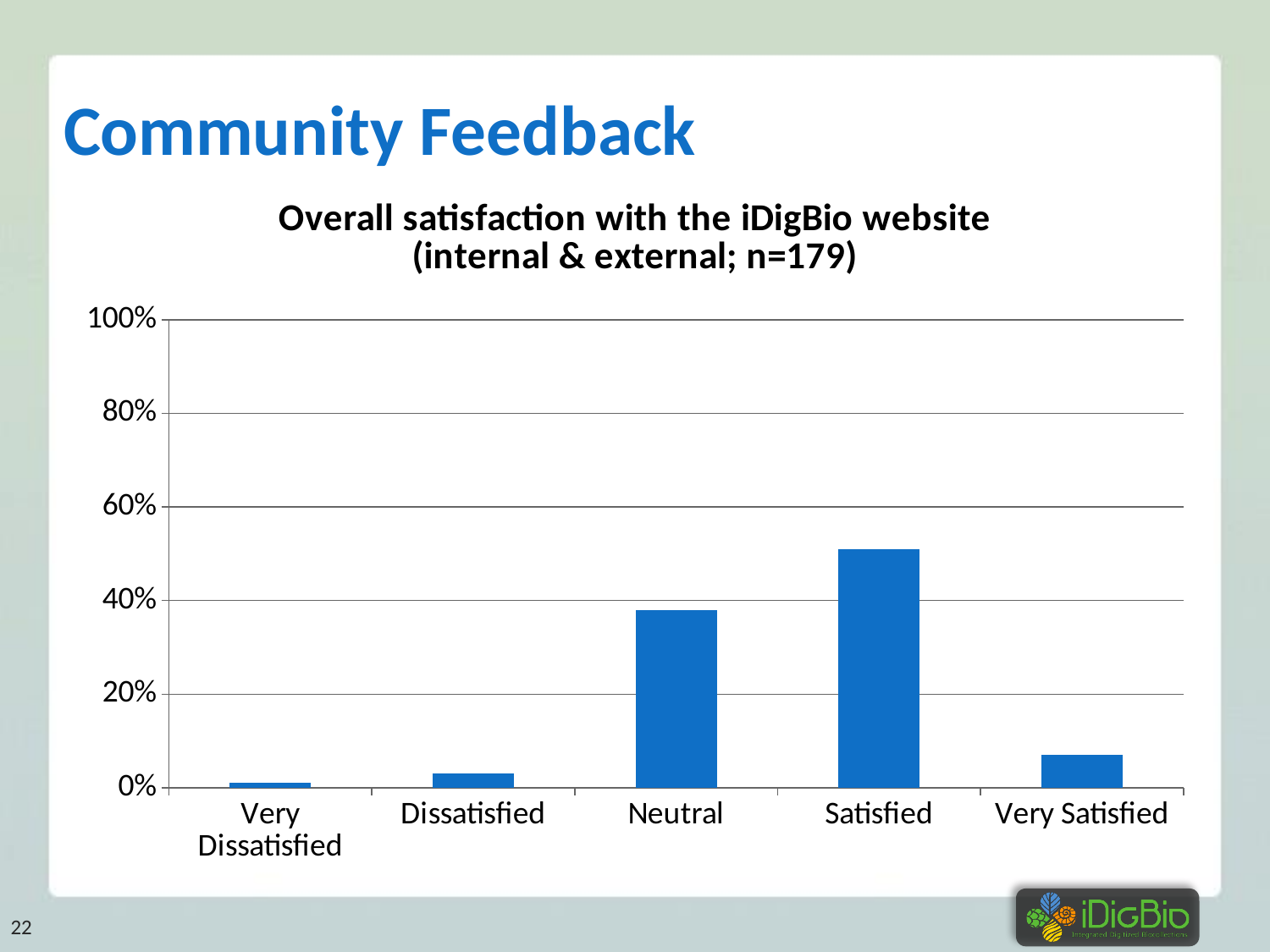
How many categories are shown on the x axis? 5 Which is larger, the value for Neutral or the value for Satisfied? Satisfied What kind of chart is shown on the slide? bar chart Which category has the highest value? Satisfied Which is larger, the value for Dissatisfied or the value for Very Satisfied? Very Satisfied What is the sample size (n) stated in the chart title? 179 Is the value for Satisfied greater or less than 60%? less What is the title of the chart? Overall satisfaction with the iDigBio website (internal & external; n=179) Is the value for Satisfied greater or less than 40%? greater Which category has the lowest value? Very Dissatisfied Is the value for Very Satisfied greater or less than 20%? less